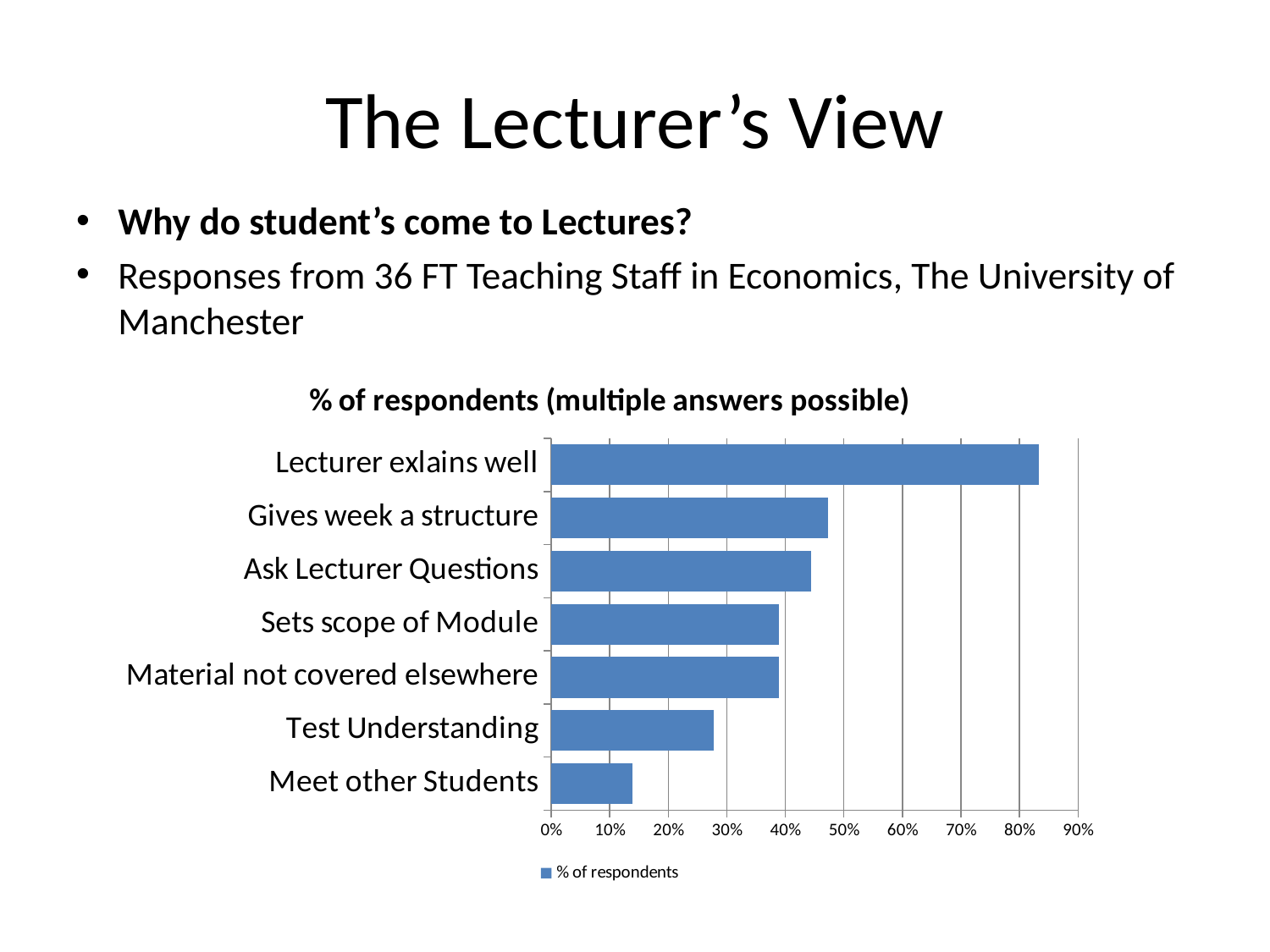
How many series does the legend list? 1 Which category has the lowest value? Meet other Students Is the value for Test Understanding greater or less than 30%? less How many categories are plotted in the chart? 7 Is the value for Meet other Students greater or less than 10%? greater What kind of chart is shown on the slide? bar chart Which category has the highest value? Lecturer exlains well Is the value for Gives week a structure greater or less than 50%? less What is the name of the series shown in the legend? % of respondents What is the title of the chart? % of respondents (multiple answers possible) Which is larger, the value for Ask Lecturer Questions or the value for Test Understanding? Ask Lecturer Questions